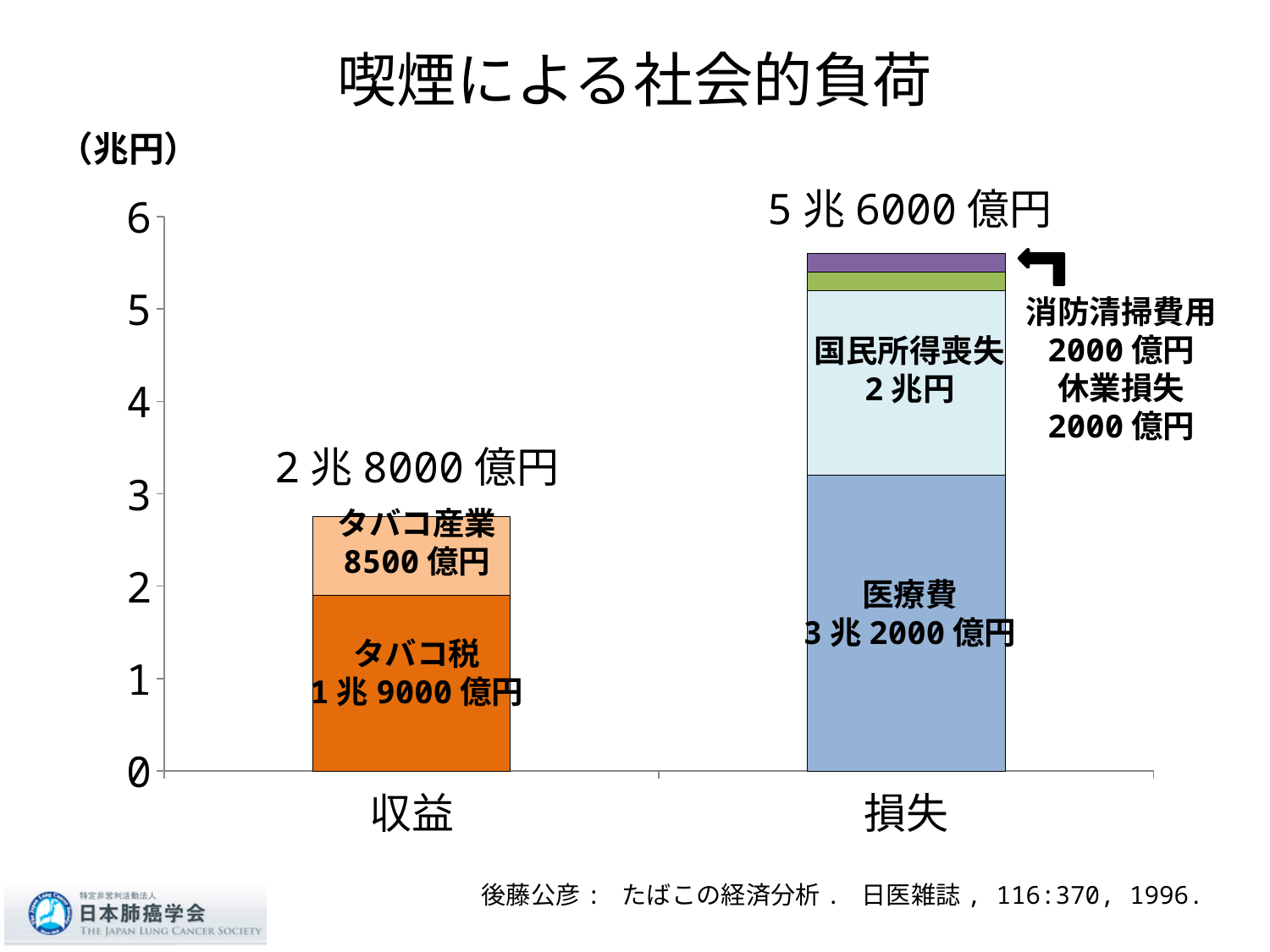
Is the total for 収益 greater or less than 3 on the y axis? less What is the value of the 国民所得喪失 segment? 2兆円 What is the total value shown for the 損失 bar? 5兆6000億円 What is the value of the 医療費 segment in the 損失 bar? 3兆2000億円 What unit is indicated for the y axis? 兆円 What type of chart is shown on the slide? stacked bar chart How many categories are shown on the x axis? 2 What is the title of the chart? 喫煙による社会的負荷 What is the value of the タバコ税 segment in the 収益 bar? 1兆9000億円 What is the difference between the 損失 total and the 収益 total? 2兆8000億円 Which bar is taller, 収益 or 損失? 損失 What is the total value shown for the 収益 bar? 2兆8000億円